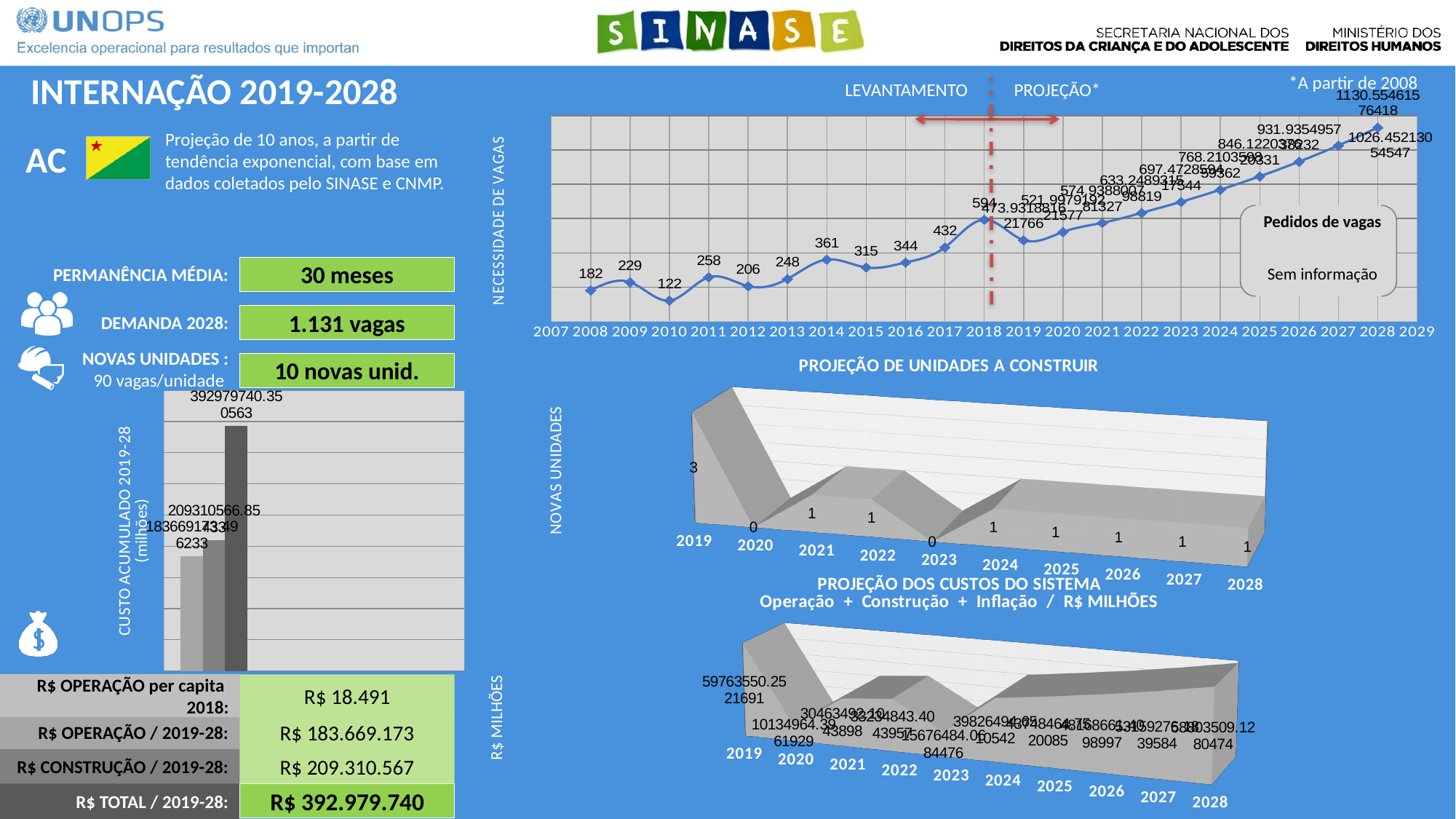
In the NECESSIDADE DE VAGAS line chart, what is the difference between the values for 2018 and 2017? 162 What kind of chart is the NECESSIDADE DE VAGAS chart at the top right? line chart In the PROJEÇÃO DE UNIDADES A CONSTRUIR chart, what is the value for 2019? 3 How many years are shown on the x axis of the PROJEÇÃO DE UNIDADES A CONSTRUIR chart? 10 In the NECESSIDADE DE VAGAS line chart, which year has the highest value? 2028 In the NECESSIDADE DE VAGAS line chart, what is the value for 2018? 594 In the PROJEÇÃO DE UNIDADES A CONSTRUIR chart, which year has the highest value? 2019 In the NECESSIDADE DE VAGAS line chart, do the values rise or fall from 2019 to 2028? rise In the NECESSIDADE DE VAGAS line chart, what is the value for 2008? 182 In the NECESSIDADE DE VAGAS line chart, what is the value for 2014? 361 In the NECESSIDADE DE VAGAS line chart, which is larger, the value for 2014 or the value for 2015? 2014 In the NECESSIDADE DE VAGAS line chart, which year has the lowest value? 2010